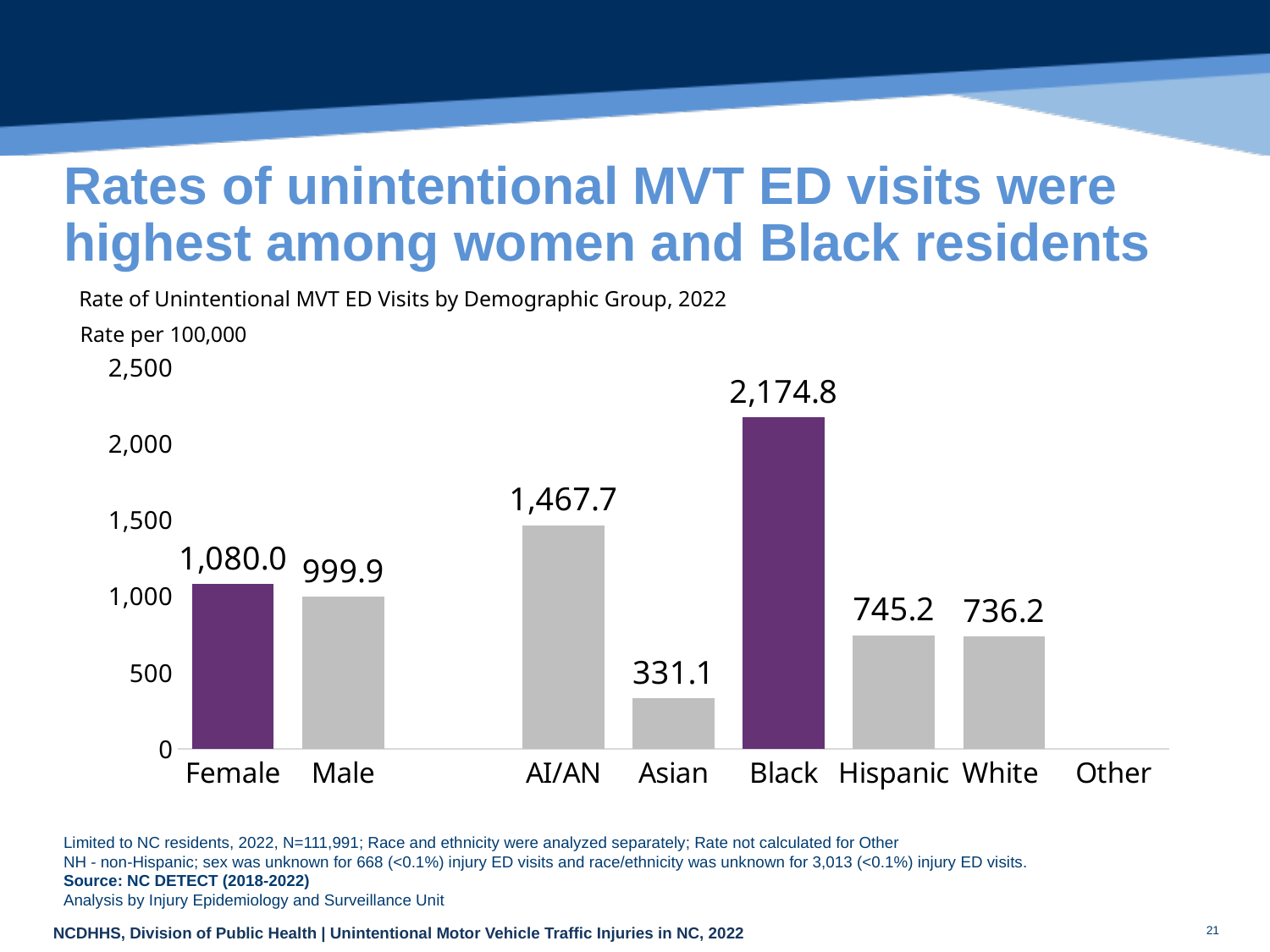
What is the rate per 100,000 for the Female group? 1,080.0 What is the difference between the Female and Male rates? 80.1 What kind of chart is shown on the slide? Bar chart What is the rate of unintentional MVT ED visits for Black residents? 2,174.8 What is the rate shown for Hispanic residents? 745.2 Which group with a plotted bar has the lowest rate? Asian How much higher is the rate for Black residents than for AI/AN residents? 707.1 Which has the higher rate, Hispanic or White? Hispanic What is the rate shown for the Asian group? 331.1 Is the value for Asian greater or less than 500? less Which demographic group has the highest rate of unintentional MVT ED visits? Black How many bars are plotted on the chart? 7